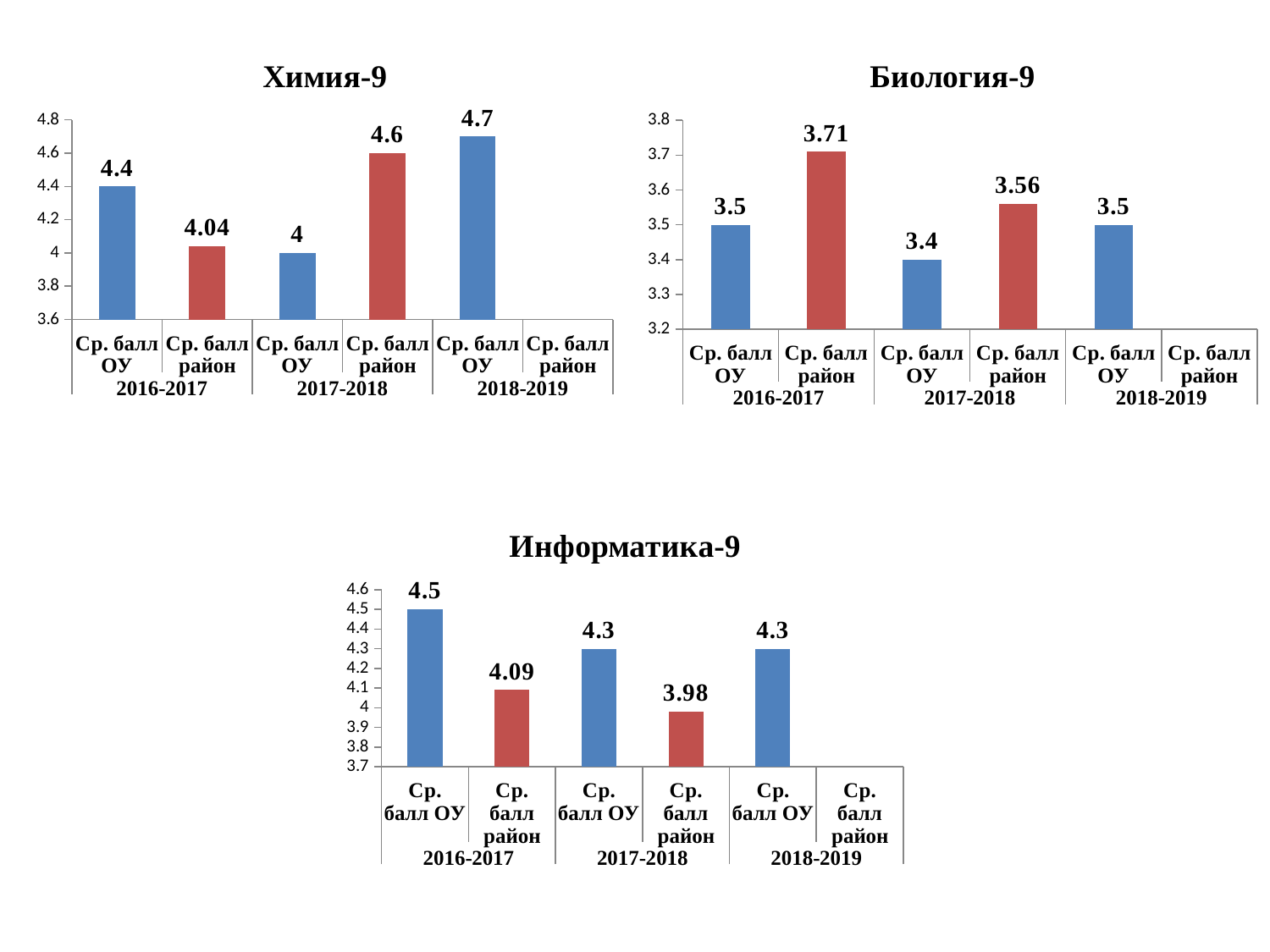
In the Химия-9 chart, what is the value for Ср. балл район in 2017-2018? 4.6 In the Биология-9 chart, what is the value for Ср. балл район in 2016-2017? 3.71 In the Химия-9 chart, what is the difference between Ср. балл ОУ and Ср. балл район in 2016-2017? 0.36 In the Химия-9 chart, what is the value for Ср. балл ОУ in 2016-2017? 4.4 In the Информатика-9 chart, what is the difference between Ср. балл ОУ in 2016-2017 and Ср. балл район in 2016-2017? 0.41 How many charts are shown on the slide? 3 In the Химия-9 chart, which bar has the highest value? Ср. балл ОУ 2018-2019 In the Информатика-9 chart, what is the value for Ср. балл район in 2017-2018? 3.98 In the Биология-9 chart, which is larger in 2017-2018: Ср. балл ОУ or Ср. балл район? Ср. балл район What type of chart is the Информатика-9 chart? Bar chart In the Биология-9 chart, which bar has the lowest value? Ср. балл ОУ 2017-2018 In the Информатика-9 chart, which bar has the highest value? Ср. балл ОУ 2016-2017